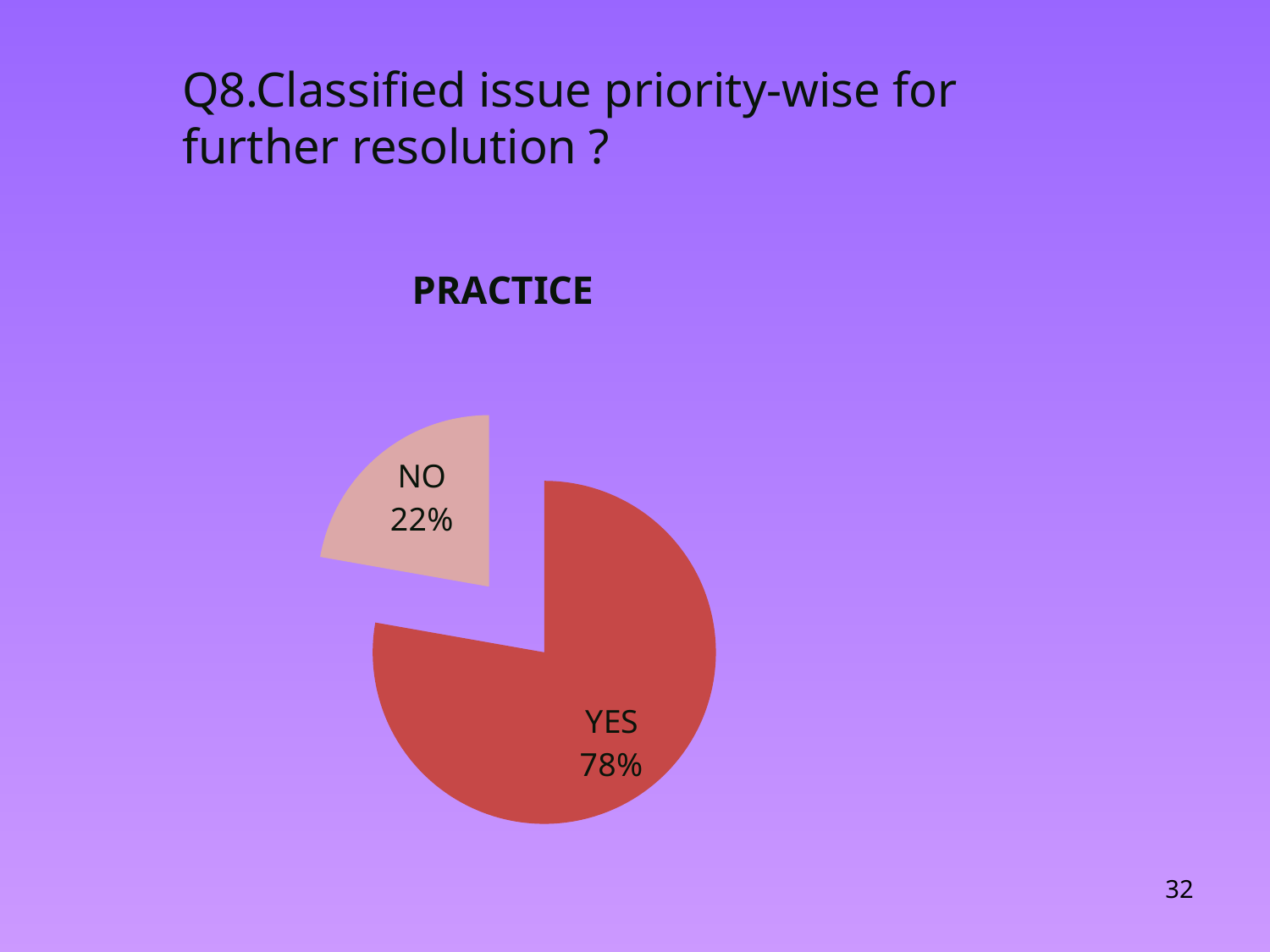
What type of chart is shown on the slide? pie chart Which slice is shown in the lighter pink colour? NO What percentage of the pie is labelled NO? 22% Which is larger, the YES slice or the NO slice? YES Which slice of the pie is the smallest? NO What is the title of the chart? PRACTICE What percentage of the pie is labelled YES? 78% Which slice of the pie is the largest? YES How many slices does the pie chart have? 2 What is the difference in percentage points between the YES and NO slices? 56 What share of the pie does the NO slice represent? 22%